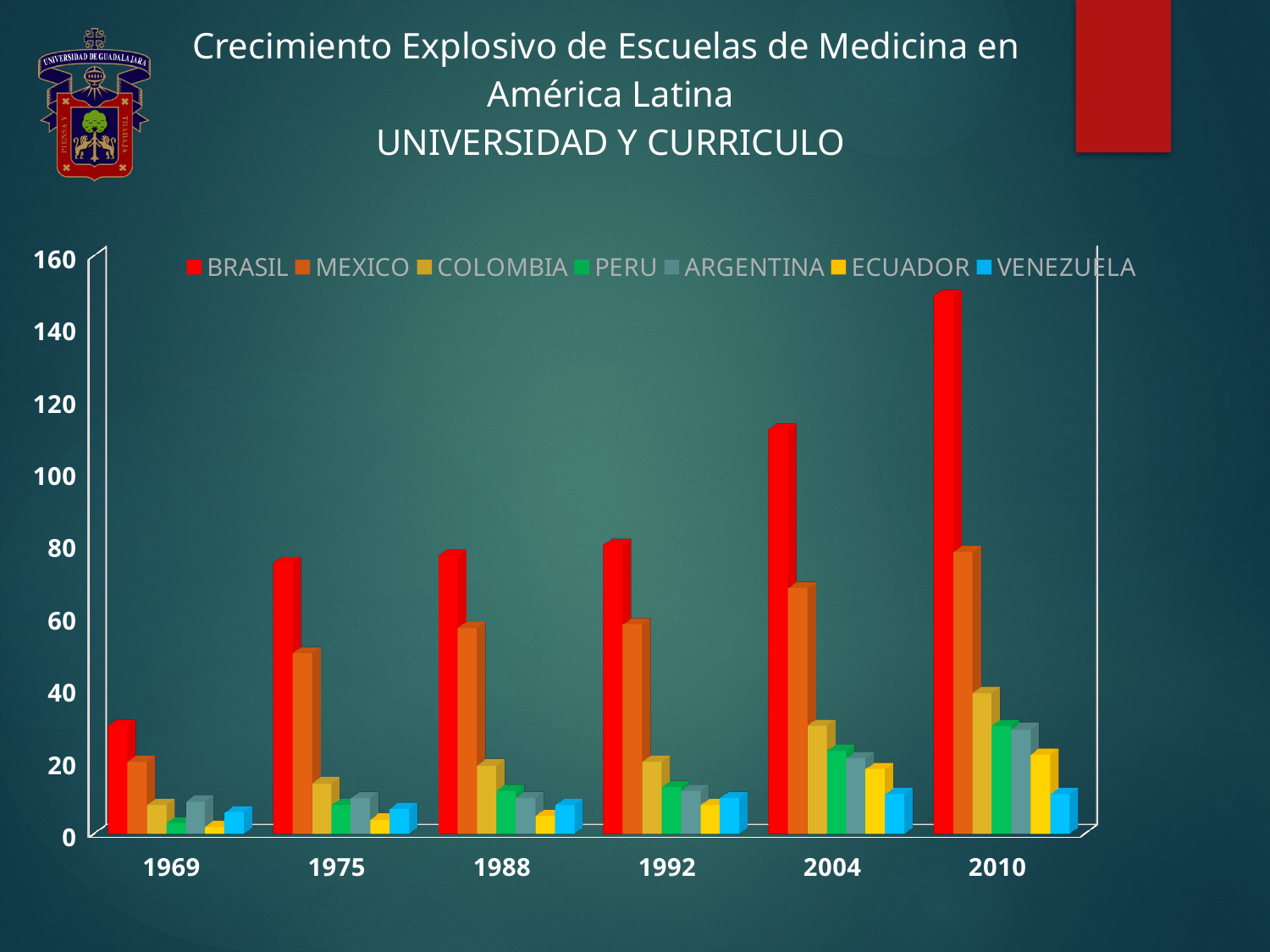
Which is larger in 2004, the value for MEXICO or the value for COLOMBIA? MEXICO How many series does the legend list? 7 Is the value for MEXICO in 1969 greater or less than 40? less Is the value for BRASIL in 2010 greater or less than 140? greater Is the value for COLOMBIA in 2010 greater or less than 60? less Which series is shown in red? BRASIL Which country has the lowest value in 1969? ECUADOR How many years are shown along the x axis? 6 Do the values for BRASIL rise or fall from 1969 to 2010? rise What kind of chart is shown on the slide? bar chart Which country has the highest value in 2010? BRASIL